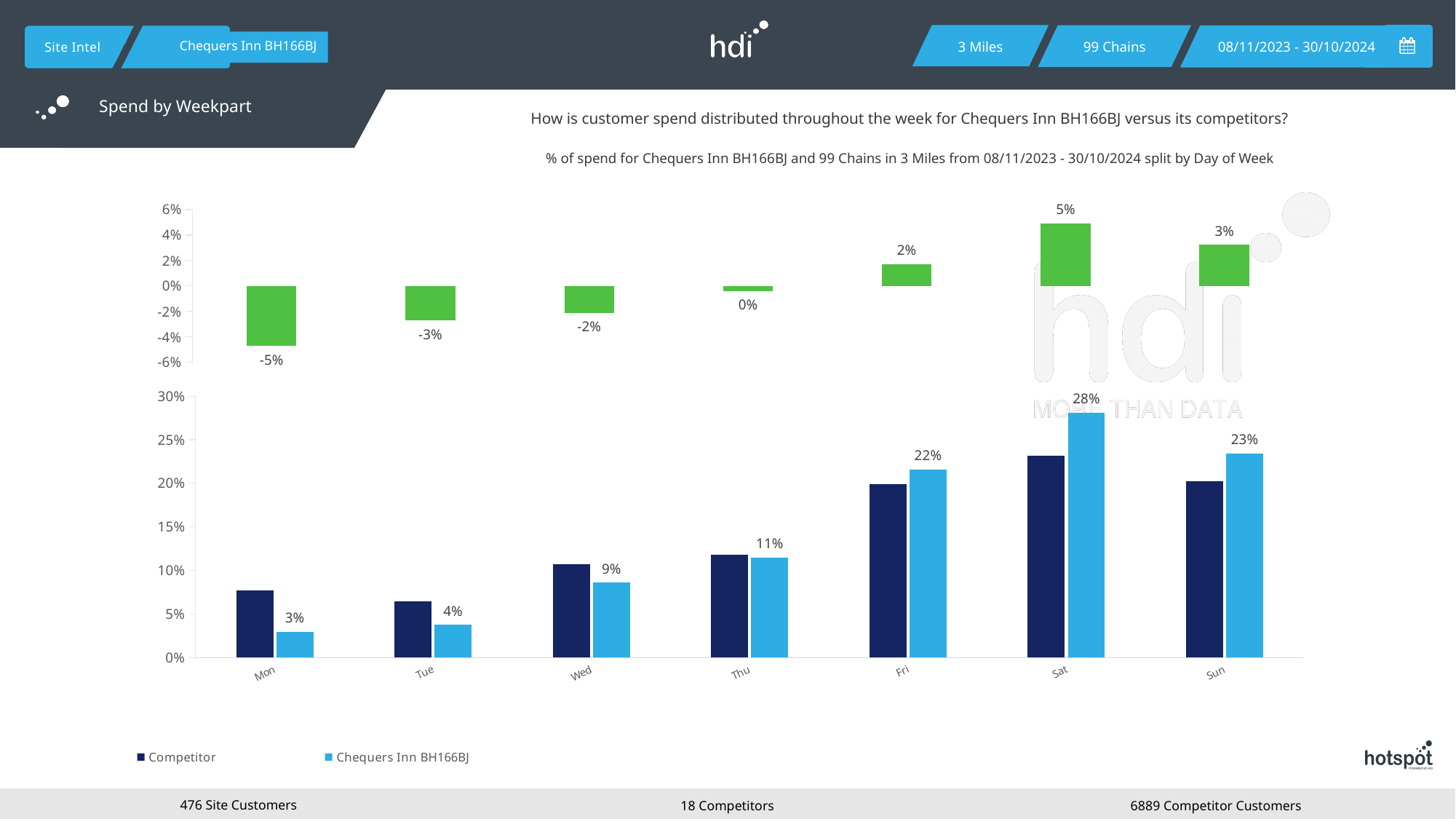
What type of chart is the bottom chart? Bar chart In the bottom chart, is the Competitor value for Fri greater or less than 15%? greater In the bottom chart, what is the difference between the Chequers Inn BH166BJ values for Sat and Sun? 5% In the bottom chart, which day has the highest value for Chequers Inn BH166BJ? Sat In the bottom chart, what is the value for Chequers Inn BH166BJ on Mon? 3% How many days of the week are shown on the x axis of the bottom chart? 7 In the top chart, what is the value shown for Mon? -5% How many series does the legend of the bottom chart list? 2 In the bottom chart, on Mon, which is larger: the Competitor bar or the Chequers Inn BH166BJ bar? Competitor In the bottom chart, which day has the lowest value for Chequers Inn BH166BJ? Mon In the bottom chart, what is the value for Chequers Inn BH166BJ on Sat? 28% In the top chart, what is the value shown for Thu? 0%